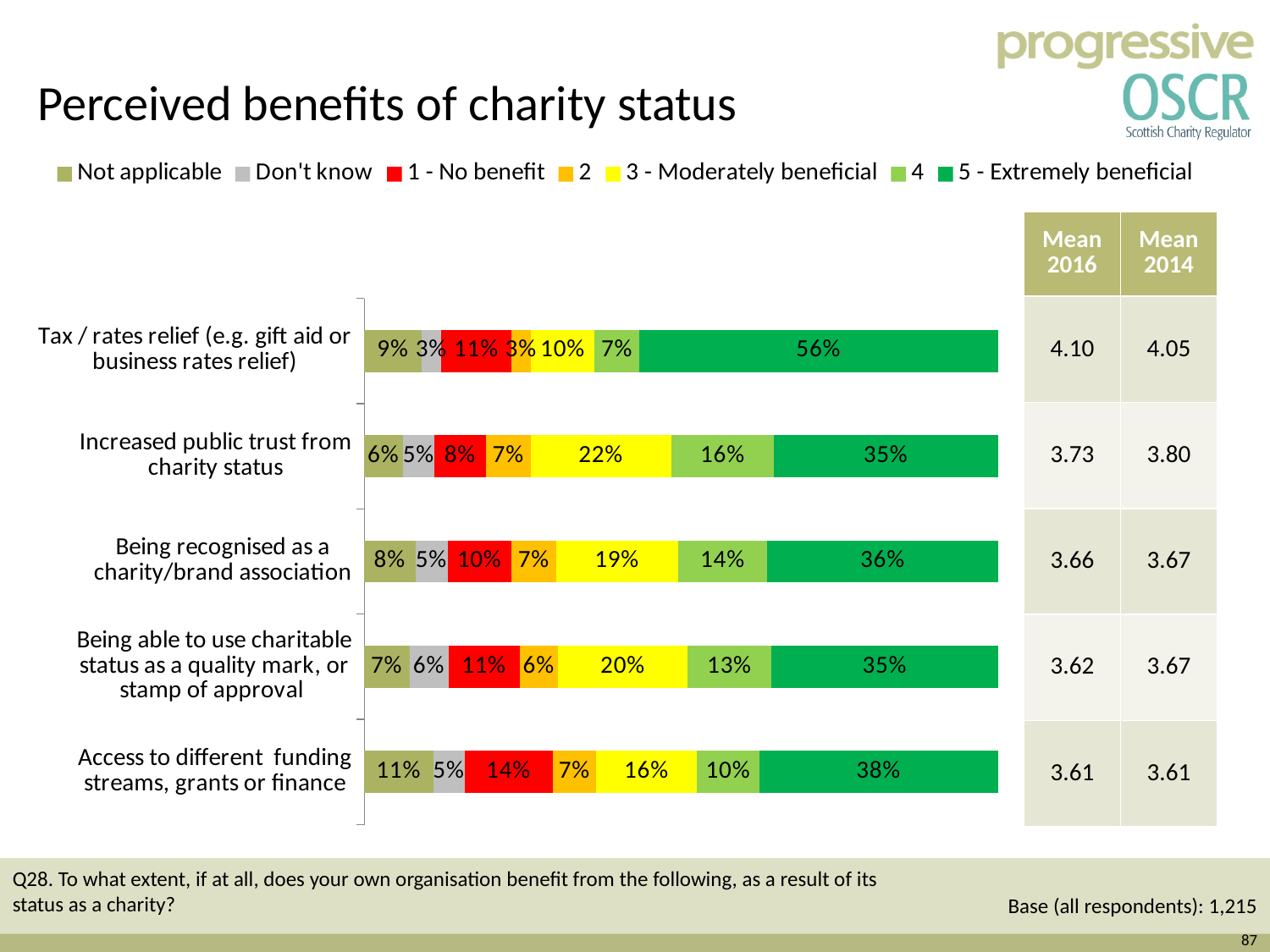
How many benefits (categories) are shown in the chart? 5 What percentage of respondents rated 'Increased public trust from charity status' as '3 - Moderately beneficial'? 22% What percentage of respondents answered 'Not applicable' for 'Being able to use charitable status as a quality mark, or stamp of approval'? 7% Which benefit has the highest share of '5 - Extremely beneficial' responses? Tax / rates relief (e.g. gift aid or business rates relief) What percentage of respondents said 'Access to different funding streams, grants or finance' was '1 - No benefit'? 14% Which colour represents '1 - No benefit' in the legend? Red How many series does the legend list? 7 What type of chart is shown on the slide? Stacked bar chart Which has a larger '1 - No benefit' share: 'Increased public trust from charity status' or 'Access to different funding streams, grants or finance'? Access to different funding streams, grants or finance What is the difference between the '5 - Extremely beneficial' share for tax / rates relief and for 'Access to different funding streams, grants or finance'? 18% Which benefit has the lowest share of '3 - Moderately beneficial' responses? Tax / rates relief (e.g. gift aid or business rates relief) What percentage of respondents rated tax / rates relief as '5 - Extremely beneficial'? 56%